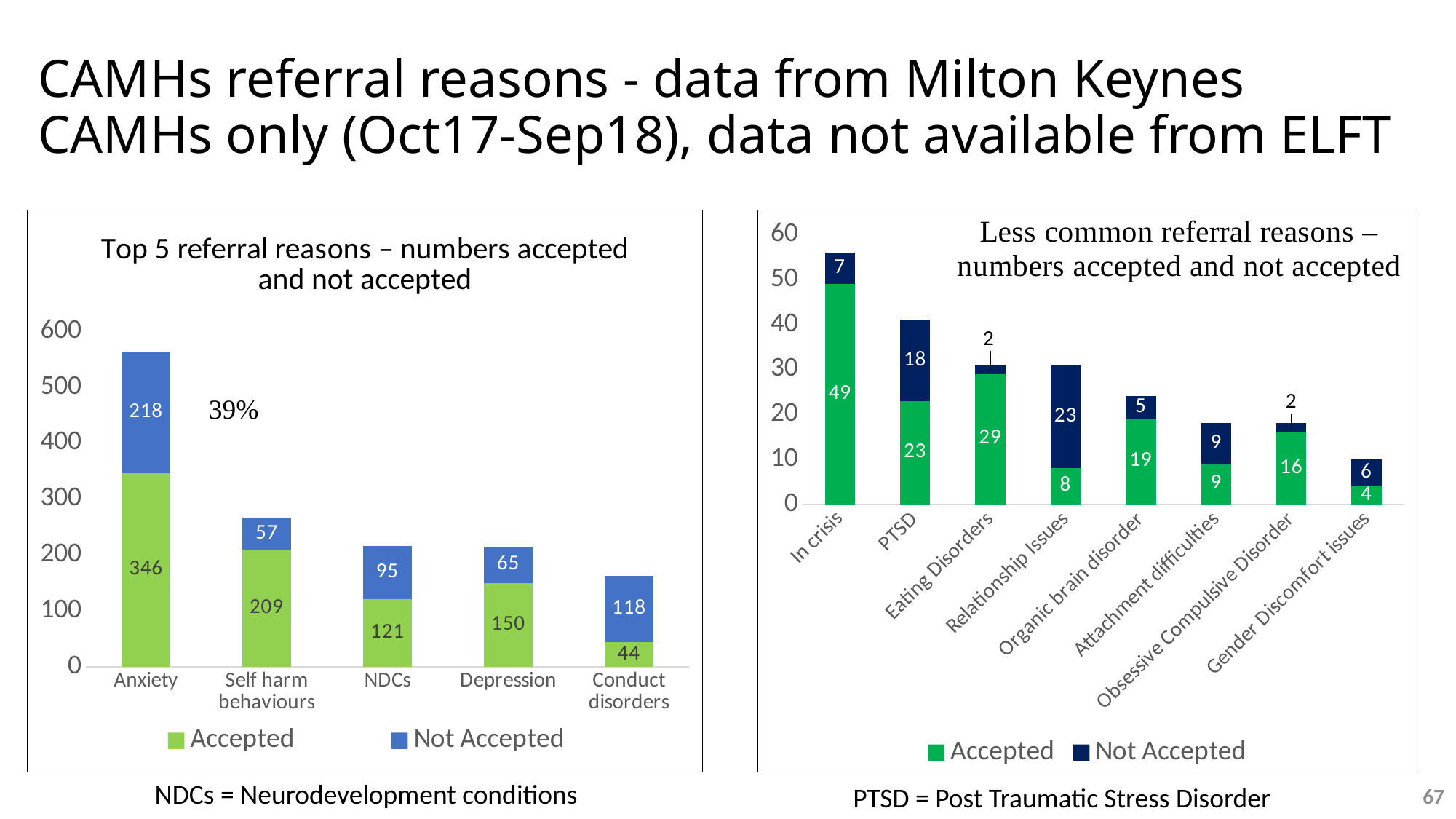
In the 'Less common referral reasons' chart, how many series does the legend list? 2 In the 'Less common referral reasons' chart, which is larger: the number of PTSD referrals accepted or the number of Eating Disorders referrals accepted? Eating Disorders In the 'Top 5 referral reasons' chart, which category has the highest number of accepted referrals? Anxiety In the 'Less common referral reasons' chart, how many Relationship Issues referrals were not accepted? 23 In the 'Top 5 referral reasons' chart, how many Conduct disorders referrals were not accepted? 118 In the 'Less common referral reasons' chart, which category has the lowest number of accepted referrals? Gender Discomfort issues What type of chart is the 'Less common referral reasons' chart? Stacked bar chart In the 'Top 5 referral reasons' chart, what is the difference between accepted and not accepted NDCs referrals? 26 In the 'Top 5 referral reasons' chart, what is the total number of Self harm behaviours referrals (accepted plus not accepted)? 266 In the 'Less common referral reasons' chart, how many In crisis referrals were accepted? 49 In the 'Top 5 referral reasons' chart, how many categories are shown on the x axis? 5 In the 'Top 5 referral reasons' chart, how many Anxiety referrals were accepted? 346